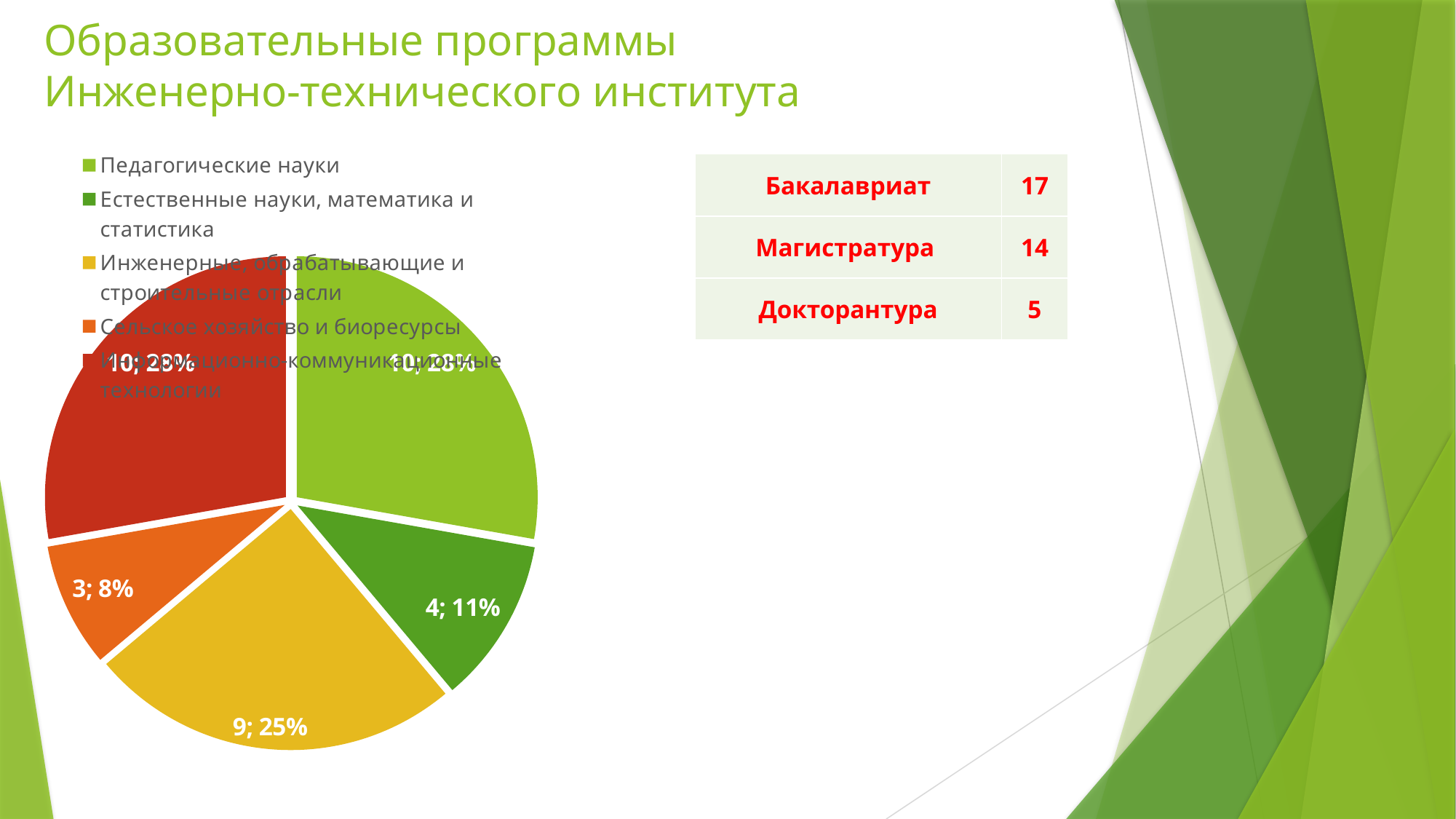
What colour is the slice for Сельское хозяйство и биоресурсы? orange What type of chart is shown on the slide? pie chart What is the difference between the values for Инженерные, обрабатывающие и строительные отрасли and Естественные науки, математика и статистика? 5 Which is larger: Инженерные, обрабатывающие и строительные отрасли or Естественные науки, математика и статистика? Инженерные, обрабатывающие и строительные отрасли What is the value shown for Сельское хозяйство и биоресурсы? 3 Which category has the smallest slice in the pie chart? Сельское хозяйство и биоресурсы What percentage share does Естественные науки, математика и статистика have in the pie chart? 11% What is the value shown for Инженерные, обрабатывающие и строительные отрасли? 9 What percentage share does Сельское хозяйство и биоресурсы have in the pie chart? 8% What is the value shown for Естественные науки, математика и статистика? 4 What percentage share does Инженерные, обрабатывающие и строительные отрасли have in the pie chart? 25% How many slices does the pie chart have? 5